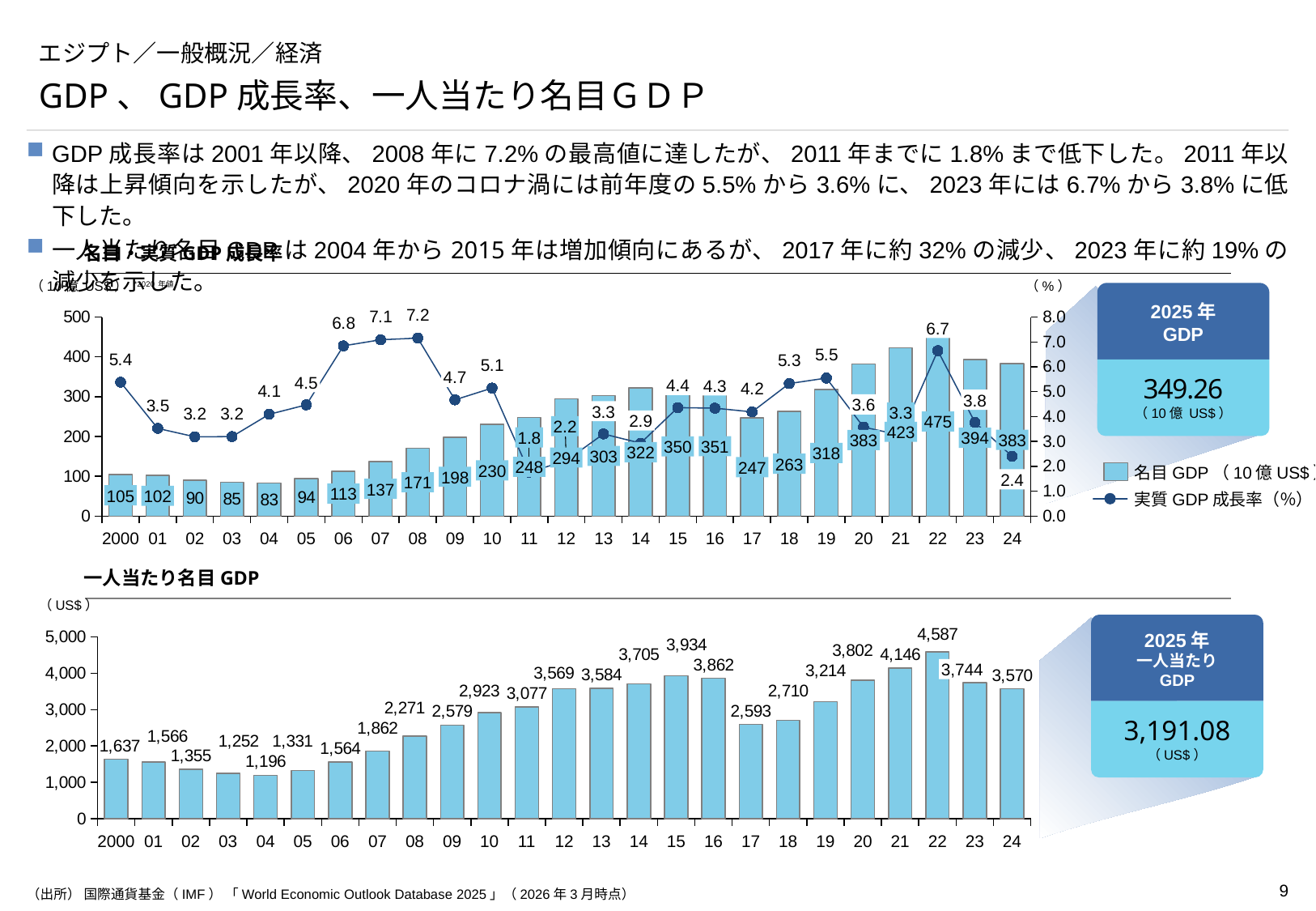
In the top chart, which year has the lowest real GDP growth rate on the line? 11 In the top chart, which year has the highest nominal GDP bar? 22 In the top chart, which is larger: the nominal GDP for 2015 or for 2016? 2016 What kind of chart is the bottom chart (一人当たり名目GDP)? Bar chart In the bottom chart (一人当たり名目GDP), what is the difference between the values for 2016 and 2017? 1,269 In the top chart, what is the nominal GDP value (10億US$) for 2022? 475 In the bottom chart (一人当たり名目GDP), how many years are plotted on the x axis? 25 In the top chart, what is the difference between the nominal GDP values for 2022 and 2023? 81 In the top chart, what is the real GDP growth rate (%) for 2008? 7.2 In the bottom chart (一人当たり名目GDP), what is the value for 2022? 4,587 In the bottom chart (一人当たり名目GDP), which year has the lowest value? 04 In the top chart, how many series does the legend list? 2